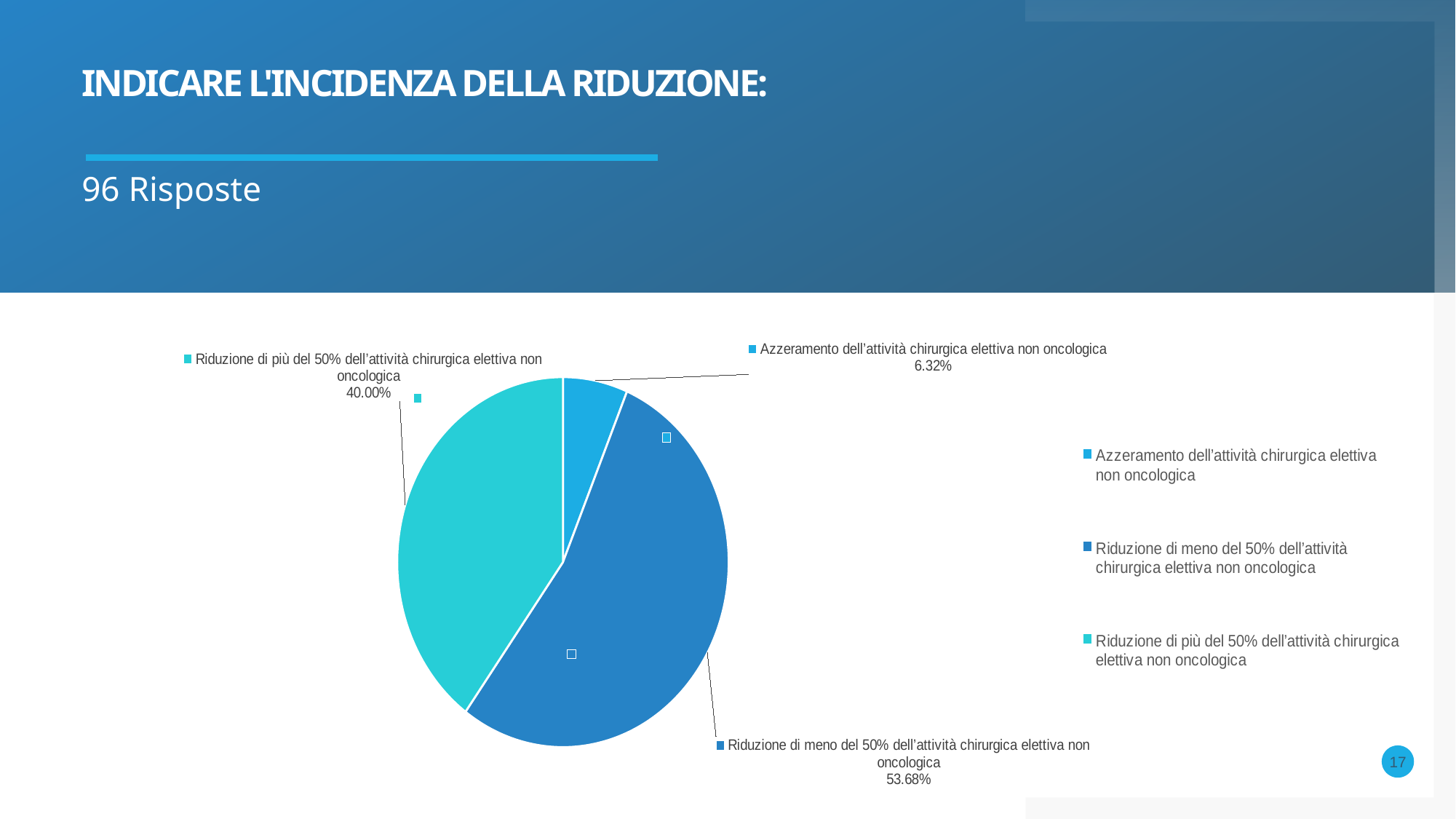
Which is larger: the 'Riduzione di più del 50%' slice or the 'Azzeramento' slice? Riduzione di più del 50% dell'attività chirurgica elettiva non oncologica Which category has the largest slice of the pie? Riduzione di meno del 50% dell'attività chirurgica elettiva non oncologica How many slices does the pie chart have? 3 How many responses (Risposte) does the slide say the chart is based on? 96 What share of the pie does 'Azzeramento dell'attività chirurgica elettiva non oncologica' have? 6.32% What is the title of the slide? INDICARE L'INCIDENZA DELLA RIDUZIONE: Which category has the smallest slice of the pie? Azzeramento dell'attività chirurgica elettiva non oncologica What is the difference in percentage points between the 'Riduzione di meno del 50%' slice and the 'Riduzione di più del 50%' slice? 13.68 What kind of chart is shown on the slide? pie chart What share of the pie does 'Riduzione di meno del 50% dell'attività chirurgica elettiva non oncologica' have? 53.68% How many entries does the legend list? 3 What share of the pie does 'Riduzione di più del 50% dell'attività chirurgica elettiva non oncologica' have? 40.00%